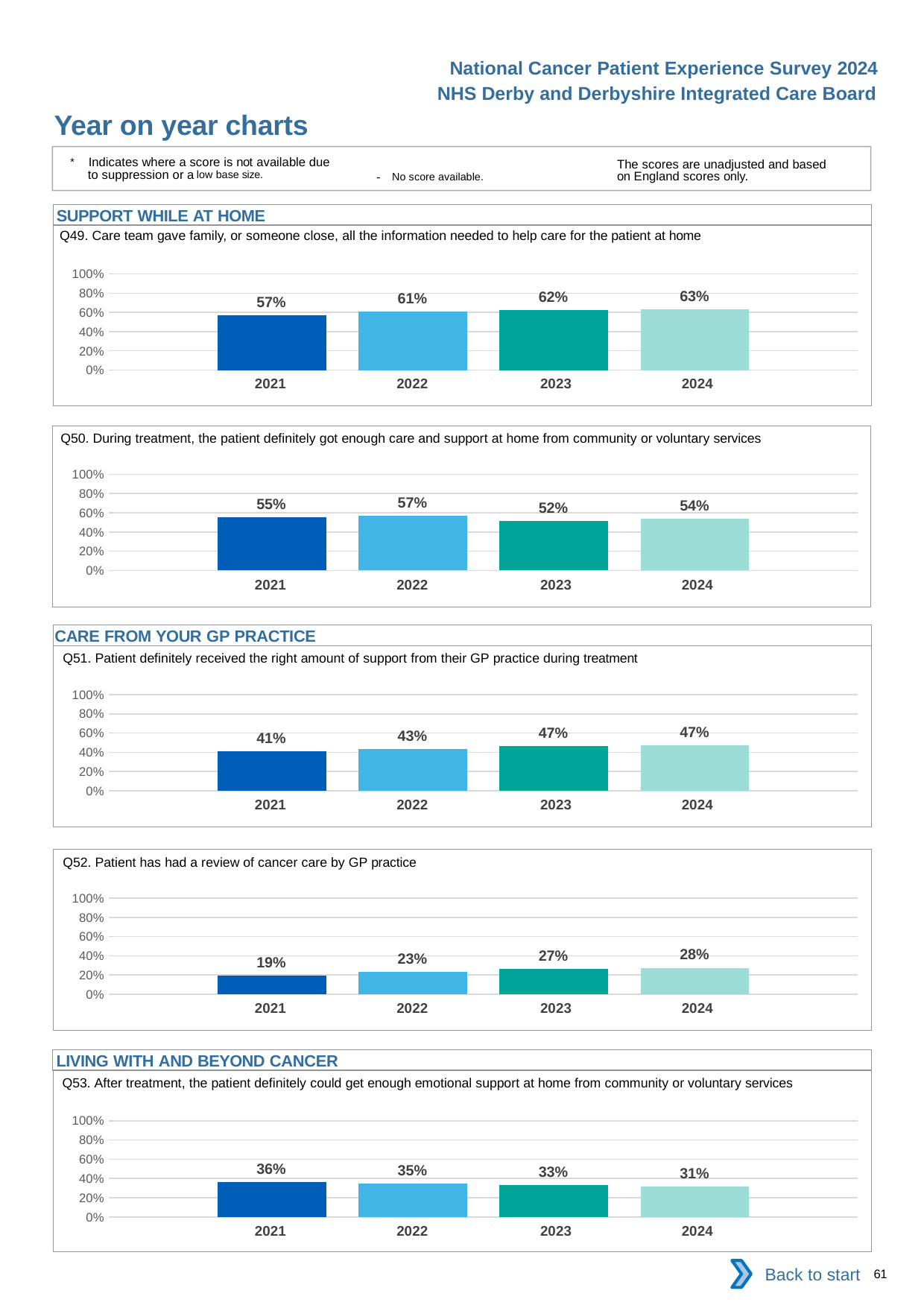
In the Q53 chart, which is larger, the value for 2021 or the value for 2024? 2021 In the Q51 chart, what is the value for 2021? 41% In the Q49 chart, which year has the lowest value? 2021 In the Q50 chart, which year has the highest value? 2022 In the Q53 chart, do the values rise or fall from 2021 to 2024? fall In the Q51 chart, is the value for 2022 greater or less than 60%? less In the Q52 chart, what is the difference between the 2024 and 2021 values? 9% In the Q52 chart, do the values rise or fall from 2021 to 2024? rise In the Q50 chart, what is the difference between the 2022 and 2023 values? 5% How many years are shown in the Q53 chart? 4 In the Q49 chart, what is the value for 2024? 63% In the Q50 chart, what is the value for 2023? 52%